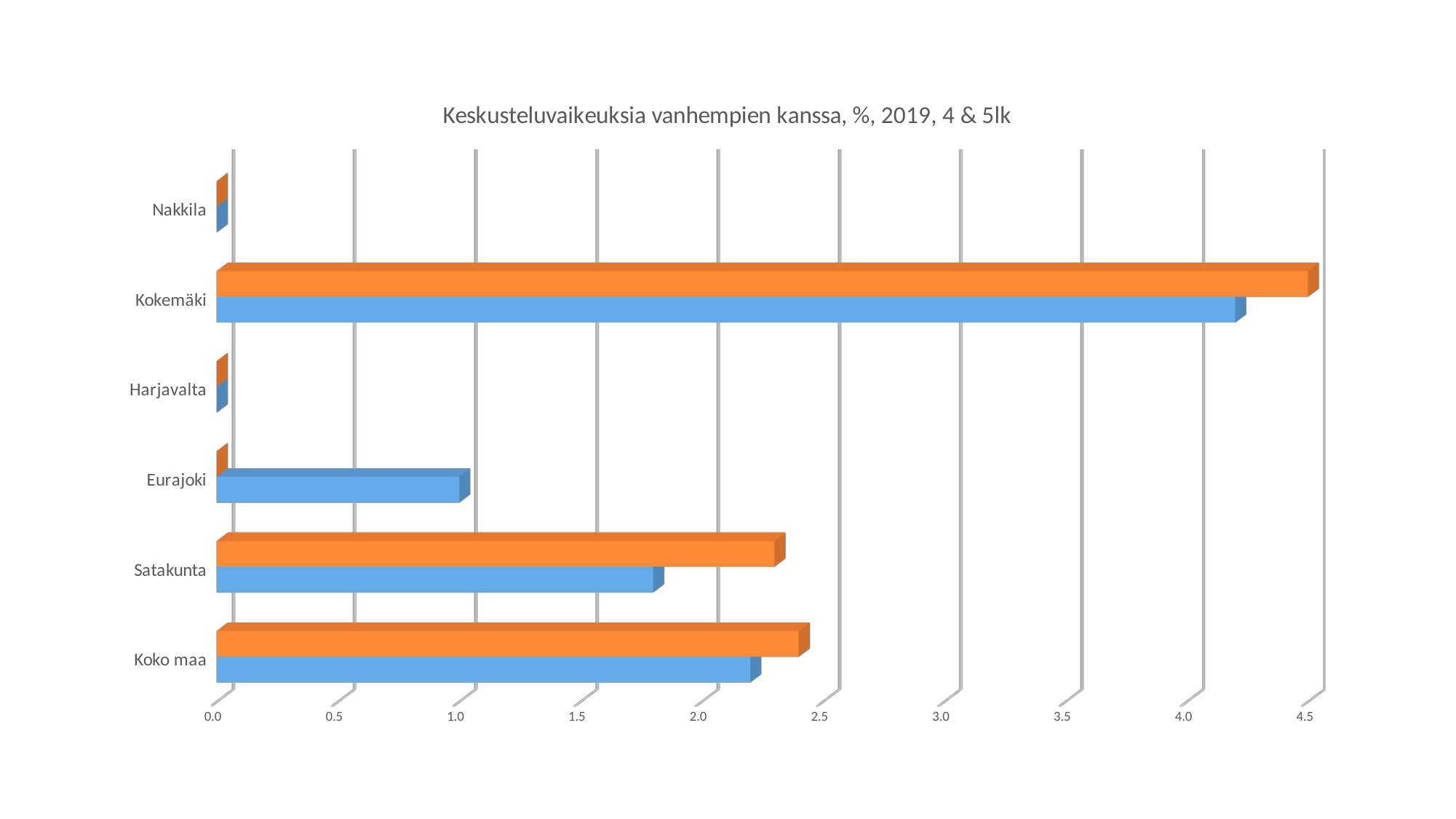
What is the title of the chart? Keskusteluvaikeuksia vanhempien kanssa, %, 2019, 4 & 5lk Is the blue bar for Kokemäki greater or less than 4.0? greater Which category has the longest orange bar? Kokemäki Is the blue bar for Satakunta greater or less than 2.0? less Is the orange bar for Kokemäki greater or less than 4.0? greater How many categories are shown on the vertical axis of the chart? 6 Which has the larger blue bar, Koko maa or Eurajoki? Koko maa What kind of chart is shown on the slide? bar chart Which has the larger orange bar, Kokemäki or Satakunta? Kokemäki Which category has the longest blue bar? Kokemäki